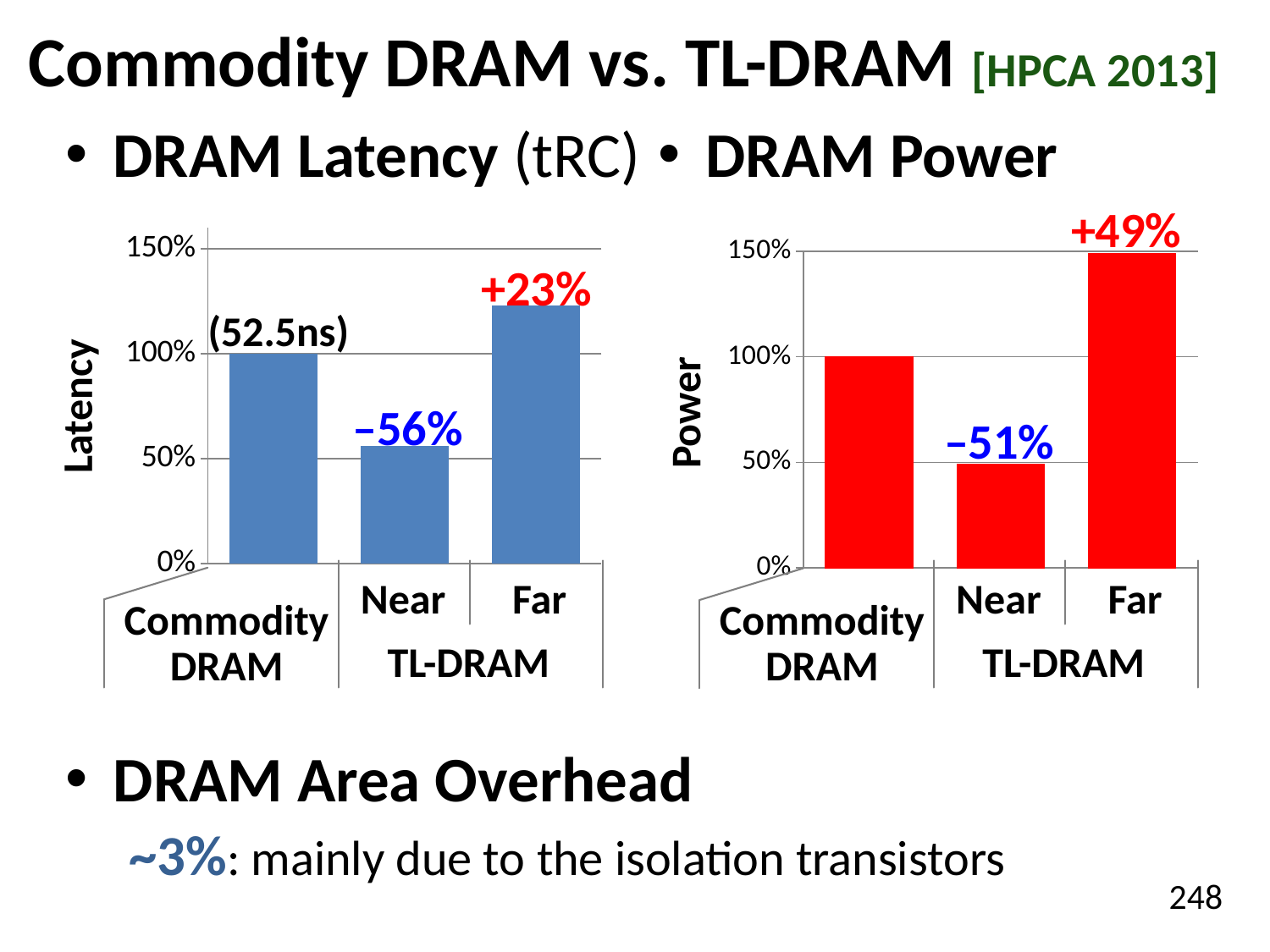
In the DRAM Latency chart, what absolute latency is printed next to the Commodity DRAM bar? 52.5ns In the DRAM Power chart, which bar is the highest? Far What kind of chart is the DRAM Latency chart? bar chart In the DRAM Power chart, is the value for Far greater or less than 100%? greater In the DRAM Latency chart, is the value for Near greater or less than 50%? greater In the DRAM Power chart, what label is printed above the Far bar? +49% In the DRAM Latency chart, what label is printed above the Far bar? +23% How many bars does the DRAM Power chart have? 3 In the DRAM Power chart, what label is printed above the Near bar? –51% In the DRAM Latency chart, which bar is the lowest? Near In the DRAM Latency chart, what label is printed above the Near bar? –56% What colour are the bars in the DRAM Power chart? red